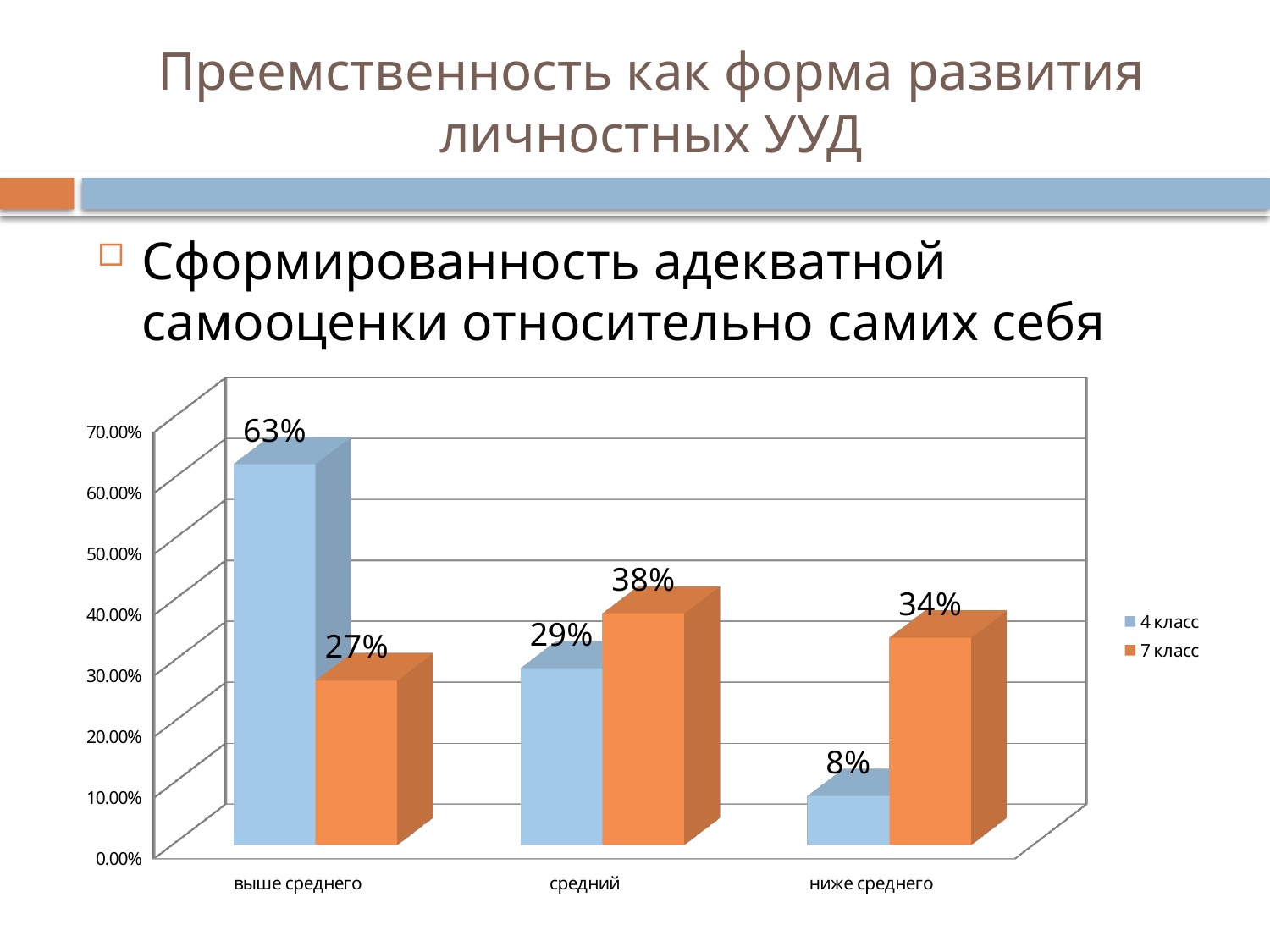
What is the difference between the 4 класс and 7 класс values in the выше среднего category? 36% What is the value for 4 класс in the выше среднего category? 63% How many series does the legend list? 2 Which category has the highest value for 4 класс? выше среднего Which is larger in the средний category: 4 класс or 7 класс? 7 класс What is the value for 7 класс in the средний category? 38% Which category has the lowest value for 7 класс? выше среднего What is the value for 7 класс in the ниже среднего category? 34% Is the value for 4 класс in the ниже среднего category greater or less than 10.00%? less Do the values for 4 класс rise or fall from выше среднего to ниже среднего? fall What kind of chart is shown on the slide? bar chart How many categories are shown on the x axis? 3